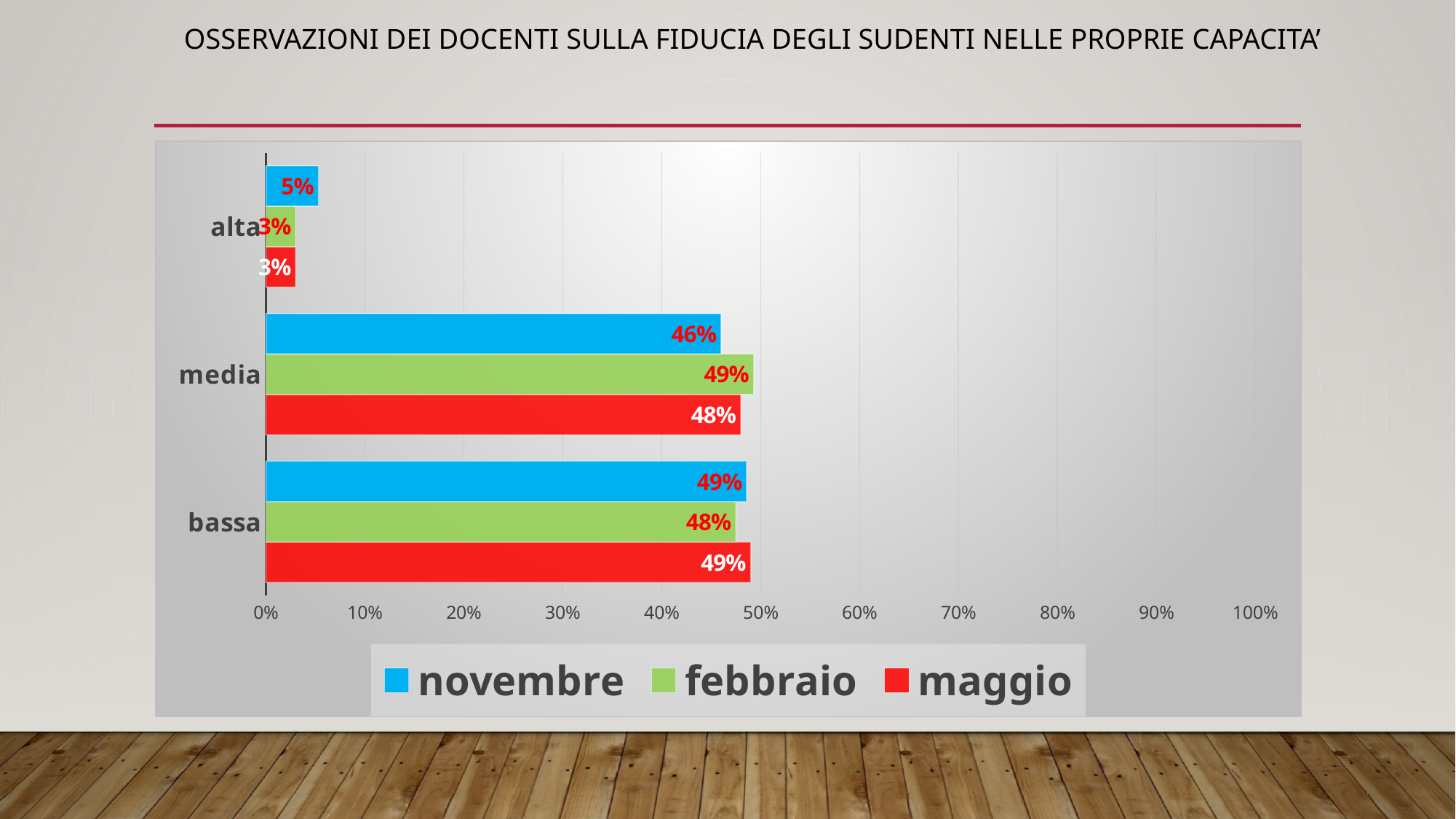
How many series does the legend list? 3 Which category has the lowest value in the maggio series? alta What is the value for 'bassa' in the maggio series? 49% Which is larger: the novembre value for 'alta' or the maggio value for 'alta'? novembre What is the value for 'alta' in the novembre series? 5% Which category has the highest value in the febbraio series? media What is the difference between the novembre values for 'bassa' and 'media'? 3% How many categories are shown on the vertical axis? 3 Which colour represents the maggio series in the legend? red What is the value for 'media' in the novembre series? 46% What is the value for 'media' in the febbraio series? 49% What kind of chart is shown on the slide? bar chart